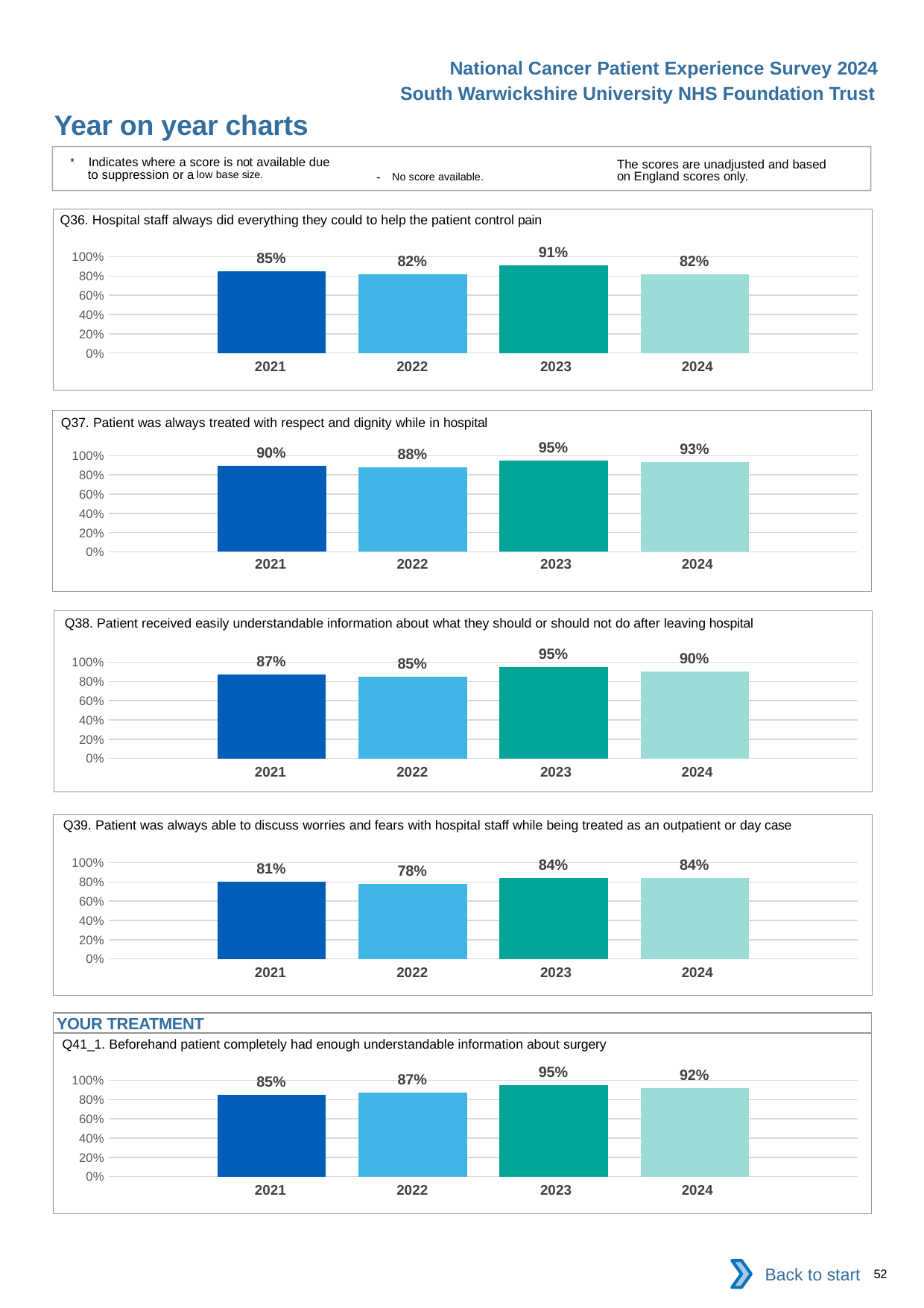
In the Q38 chart (Patient received easily understandable information about what they should or should not do after leaving hospital), what is the difference between the 2023 and 2022 values? 10 percentage points In the Q36 chart (Hospital staff always did everything they could to help the patient control pain), what is the value for 2023? 91% In the Q36 chart, is the value for 2021 larger or smaller than the value for 2022? larger In the Q37 chart (Patient was always treated with respect and dignity while in hospital), which year has the highest value? 2023 How many charts are shown on the slide? 5 In the Q39 chart (Patient was always able to discuss worries and fears with hospital staff), which year has the lowest value? 2022 How many years are shown in the Q37 chart? 4 What kind of chart is the Q39 chart? bar chart In the Q41_1 chart (Beforehand patient completely had enough understandable information about surgery), what is the value for 2024? 92% In the Q39 chart, what is the value for 2024? 84% In the Q38 chart, is the value for 2024 greater or less than 80%? greater In the Q41_1 chart, what is the difference between the 2023 and 2021 values? 10 percentage points